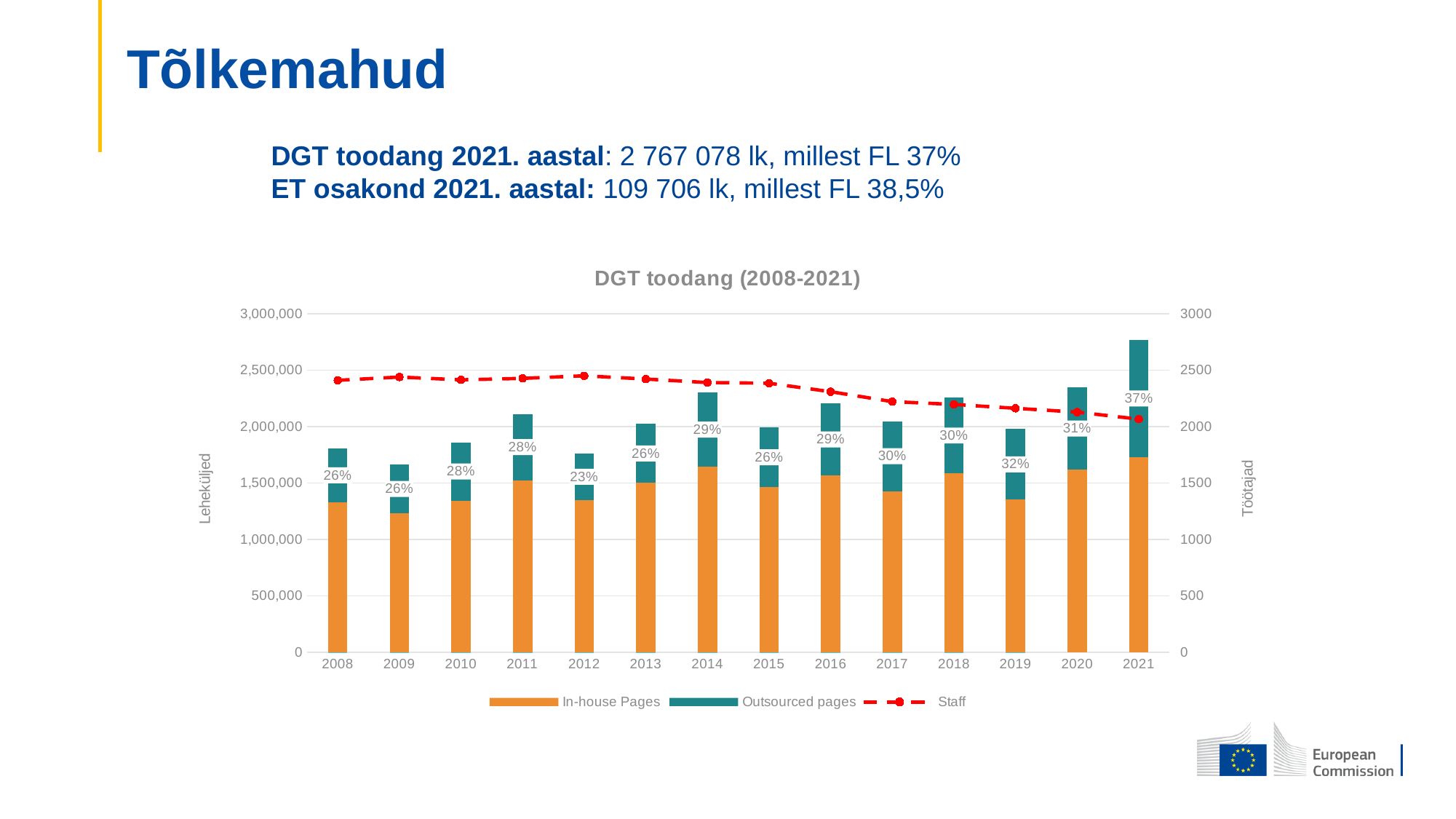
What percentage label is shown on the 2019 bar in the DGT toodang (2008-2021) chart? 32% Which year has a taller total stacked bar, 2021 or 2009? 2021 Which year has the lowest percentage label in the DGT toodang (2008-2021) chart? 2012 What percentage label is shown on the 2021 bar in the DGT toodang (2008-2021) chart? 37% Which year has the highest percentage label in the DGT toodang (2008-2021) chart? 2021 What is the difference between the percentage labels for 2021 and 2012 in the DGT toodang (2008-2021) chart? 14% How many series does the legend of the DGT toodang (2008-2021) chart list? 3 Is the total height of the 2021 stacked bar greater or less than 2,500,000? greater How many years are shown on the x axis of the DGT toodang (2008-2021) chart? 14 Does the Staff line rise or fall from 2008 to 2021 in the DGT toodang (2008-2021) chart? fall Is the total height of the 2012 stacked bar greater or less than 2,000,000? less What percentage label is shown on the 2012 bar in the DGT toodang (2008-2021) chart? 23%